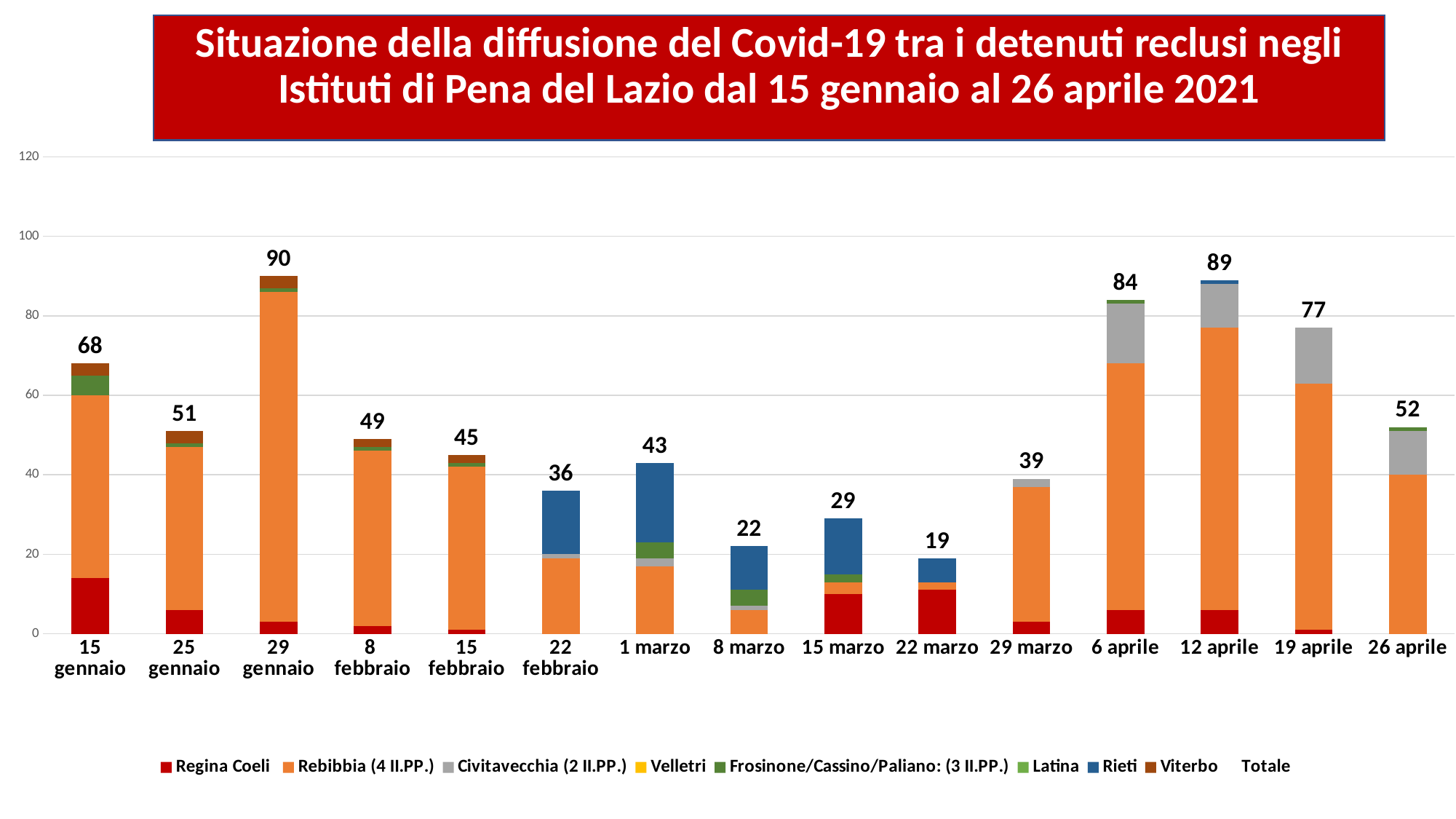
How many dates are shown on the x axis? 15 What is the total value shown for 29 gennaio? 90 Which has a larger total, 6 aprile or 19 aprile? 6 aprile Which date has the lowest total? 22 marzo How many entries does the legend list? 9 What is the total value shown for 22 marzo? 19 What is the difference between the totals for 12 aprile and 6 aprile? 5 Which date has the highest total? 29 gennaio What is the total value shown for 6 aprile? 84 What kind of chart is shown on the slide? stacked bar chart Is the Rebibbia (4 II.PP.) value for 12 aprile greater or less than 60? greater What is the difference between the totals for 29 gennaio and 22 marzo? 71